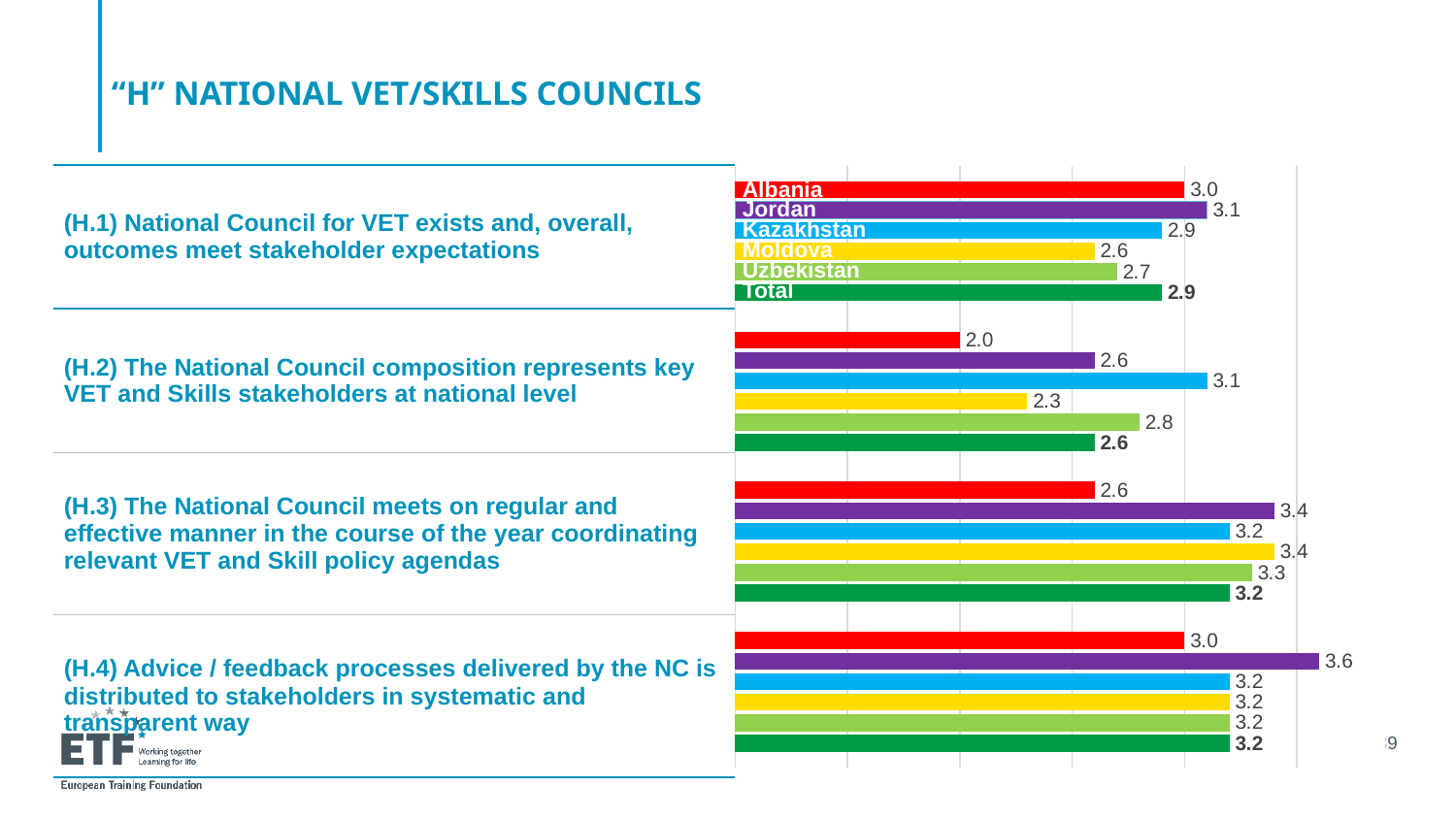
In the H.3 chart, which is larger, the Albania (red) bar or the Uzbekistan (light green) bar? Uzbekistan In the H.1 chart, what is the Total value? 2.9 What type of chart is used for the H.1 indicator? Bar chart In the H.3 chart, what is the value of the Total bar? 3.2 How many bars are plotted in the H.1 chart? 6 In the H.4 chart, what is the value of the purple bar (Jordan)? 3.6 In the H.4 chart, which country has the lowest value? Albania In the H.2 chart, what is the value of the red bar (Albania)? 2.0 In the H.1 chart, what is the value for Jordan? 3.1 In the H.2 chart, which country has the highest value? Kazakhstan In the H.2 chart, what is the difference between the Kazakhstan (blue) bar and the Albania (red) bar? 1.1 In the H.1 chart, which country has the lowest value? Moldova